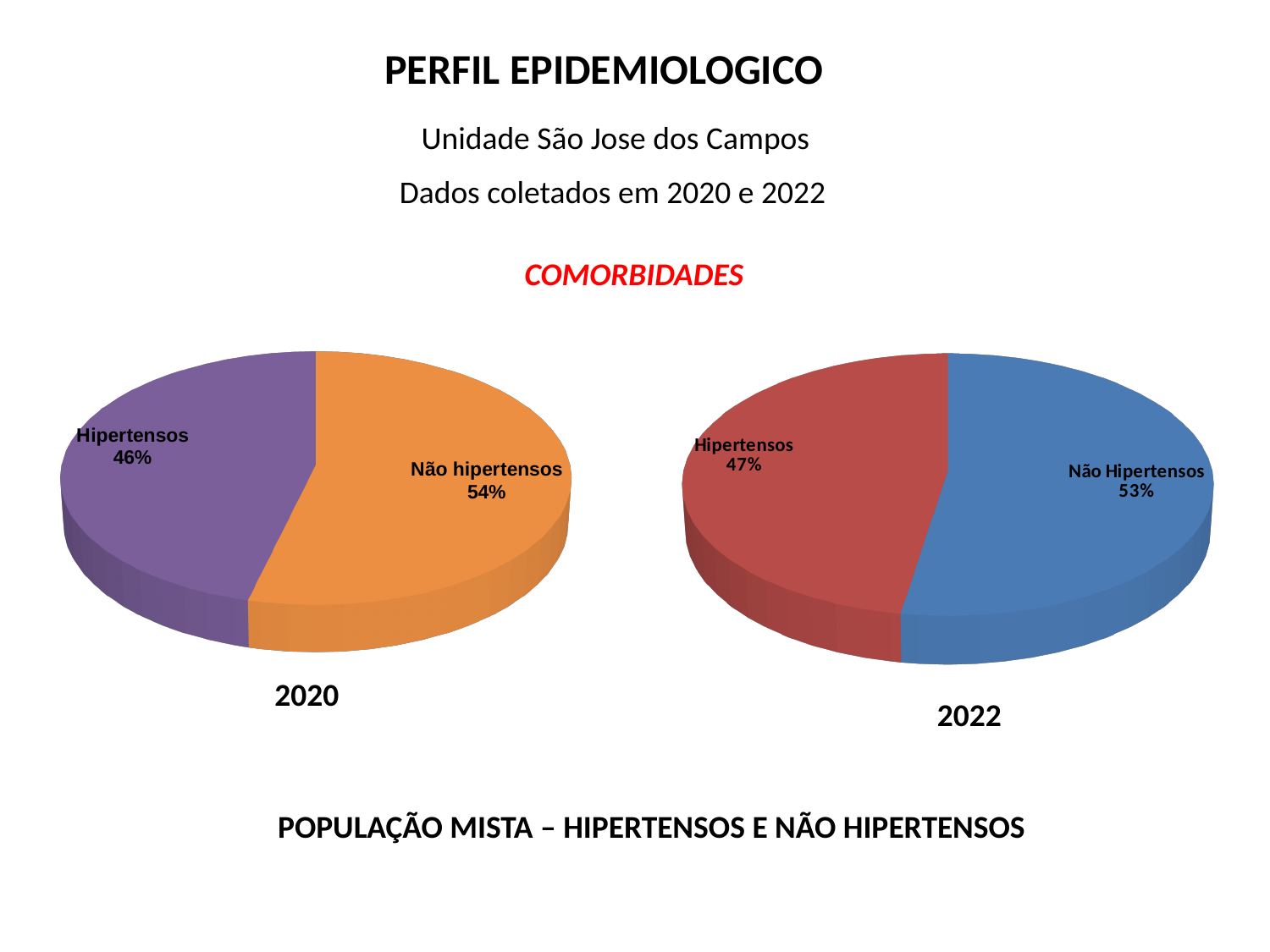
What type of chart is used for the 2022 data? Pie chart In the 2022 pie chart, what colour is the Hipertensos slice? Red Comparing the two charts, is the Hipertensos share larger in 2020 or in 2022? 2022 In the 2020 pie chart, what share is labelled for Não hipertensos? 54% In the 2020 pie chart, what is the difference in percentage points between Não hipertensos and Hipertensos? 8 In the 2020 pie chart, which slice is the largest? Não hipertensos In the 2022 pie chart, which slice is the smallest? Hipertensos How many slices does the 2020 pie chart have? 2 In the 2022 pie chart, what share is labelled for Hipertensos? 47% In the 2022 pie chart, what share is labelled for Não Hipertensos? 53% In the 2022 pie chart, what is the difference in percentage points between Não Hipertensos and Hipertensos? 6 In the 2020 pie chart, what share is labelled for Hipertensos? 46%